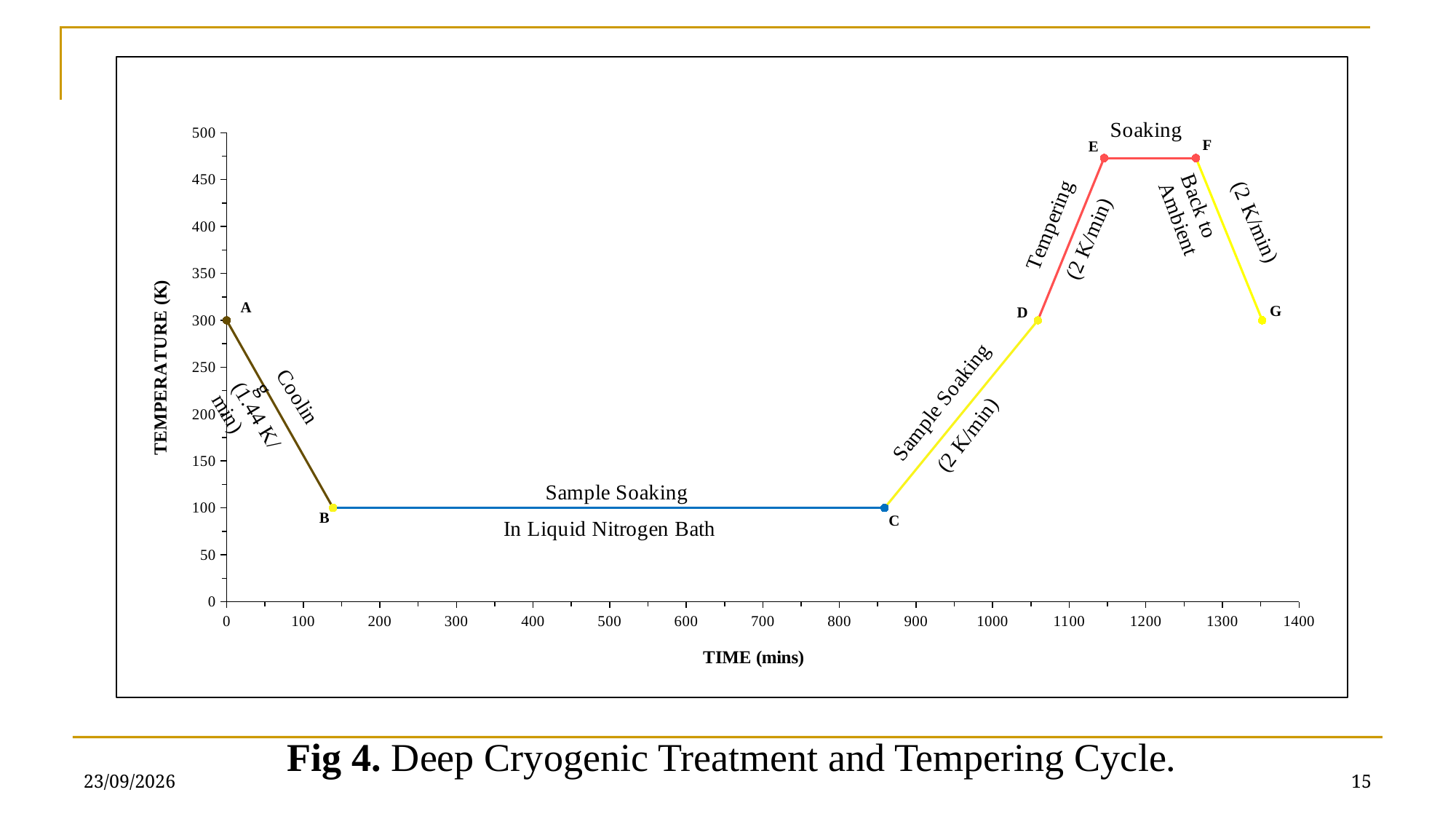
Is the time at point C greater or less than 800? greater Is the temperature at point F greater or less than 500? less What is the temperature at point D? 300 What is the temperature at point A? 300 What is the title of the x axis? TIME (mins) How many labelled points (A to G) are marked on the curve? 7 Is the temperature at point E greater or less than 450? greater Does the temperature rise or fall from point A to point B? fall What is the temperature at point B? 100 What kind of chart is shown on the slide? line chart Which point has the higher temperature, D or E? E Does the temperature rise or fall from point C to point D? rise